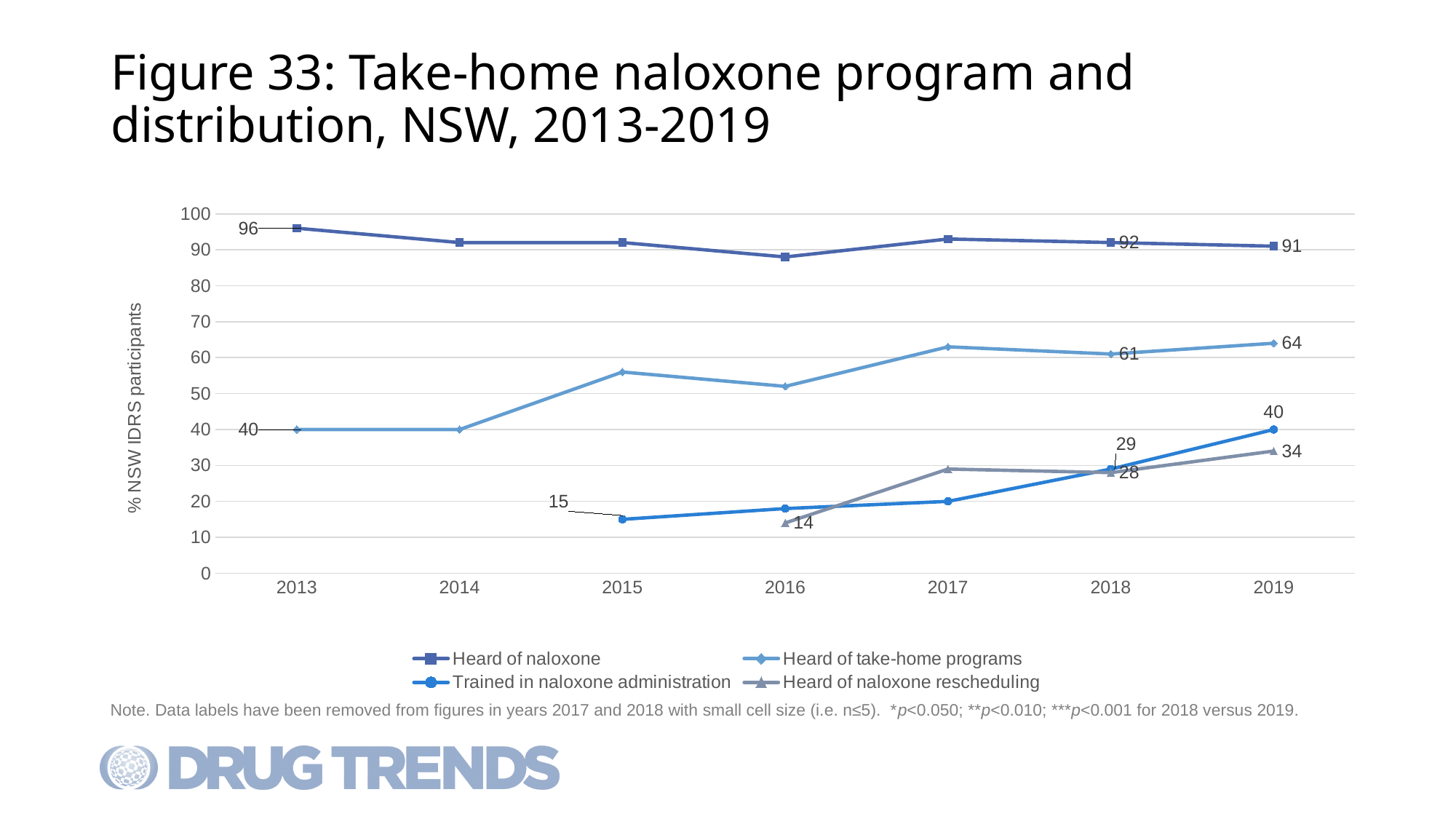
Is the value for 'Heard of naloxone' in 2016 greater or less than 90? less By how many percentage points did 'Heard of naloxone' fall from 2013 to 2019? 5 Is the value for 'Heard of take-home programs' in 2015 greater or less than 50? greater How many series does the legend list? 4 What kind of chart is shown on the slide? line chart Does the 'Trained in naloxone administration' line rise or fall from 2015 to 2019? rise What is the value for 'Heard of naloxone rescheduling' in 2016? 14 What is the difference between the 2019 and 2018 values for 'Trained in naloxone administration'? 11 In 2019, which is larger: 'Trained in naloxone administration' or 'Heard of naloxone rescheduling'? Trained in naloxone administration What is the value for 'Heard of take-home programs' in 2019? 64 What percentage of NSW IDRS participants had heard of naloxone in 2013? 96 What is the value for 'Trained in naloxone administration' in 2015? 15